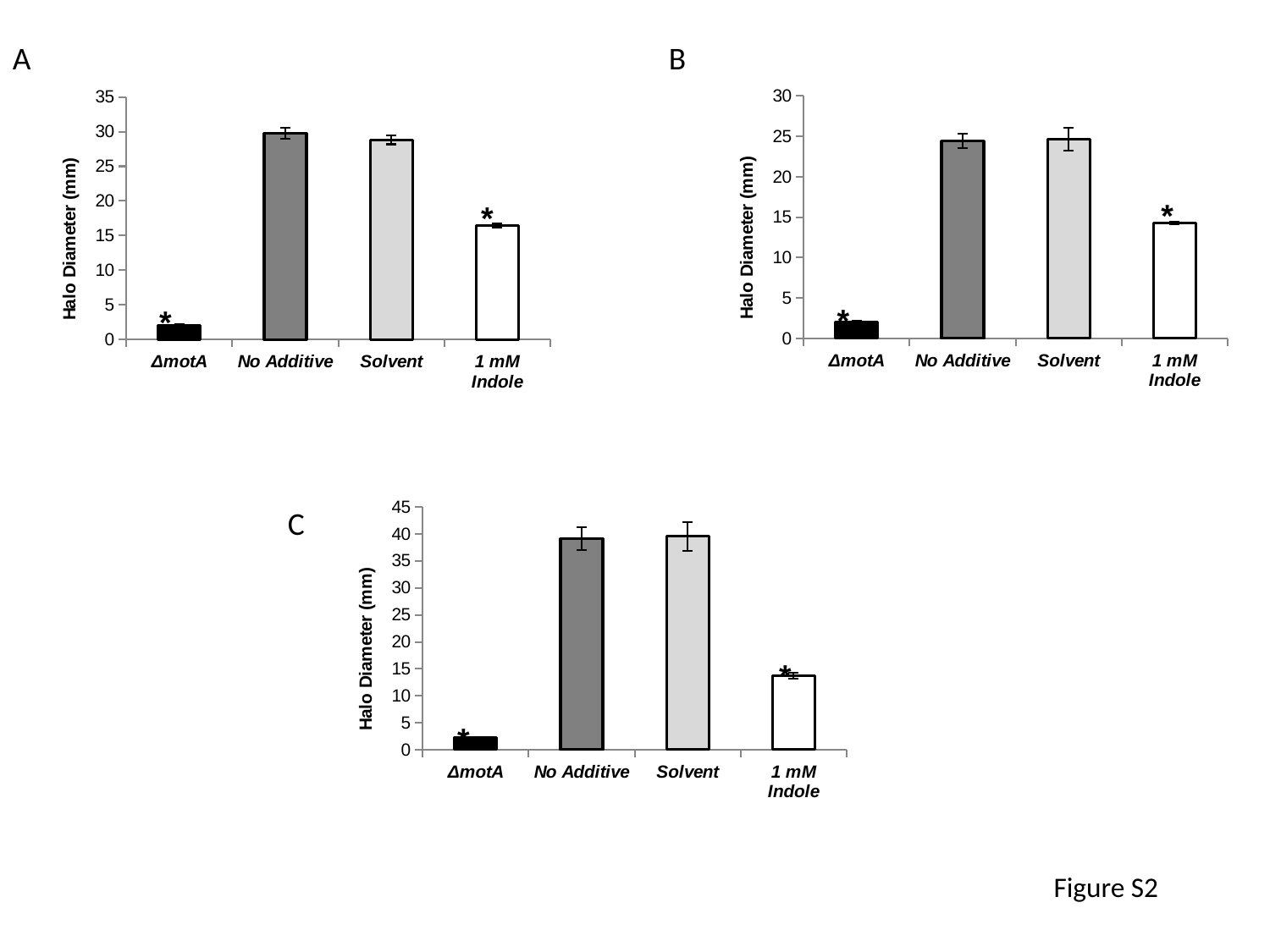
In chart A, is the value for 1 mM Indole greater or less than 15? greater In chart A, is the value for No Additive greater or less than 25? greater In chart A, which category has the lowest halo diameter? ΔmotA How many categories are shown on the x axis of chart B? 4 In chart C, is the value for No Additive greater or less than 35? greater In chart B, which category has the lowest halo diameter? ΔmotA In chart C, which category has the lowest halo diameter? ΔmotA What type of chart is chart C? Bar chart In chart C, which is larger, the value for Solvent or the value for 1 mM Indole? Solvent